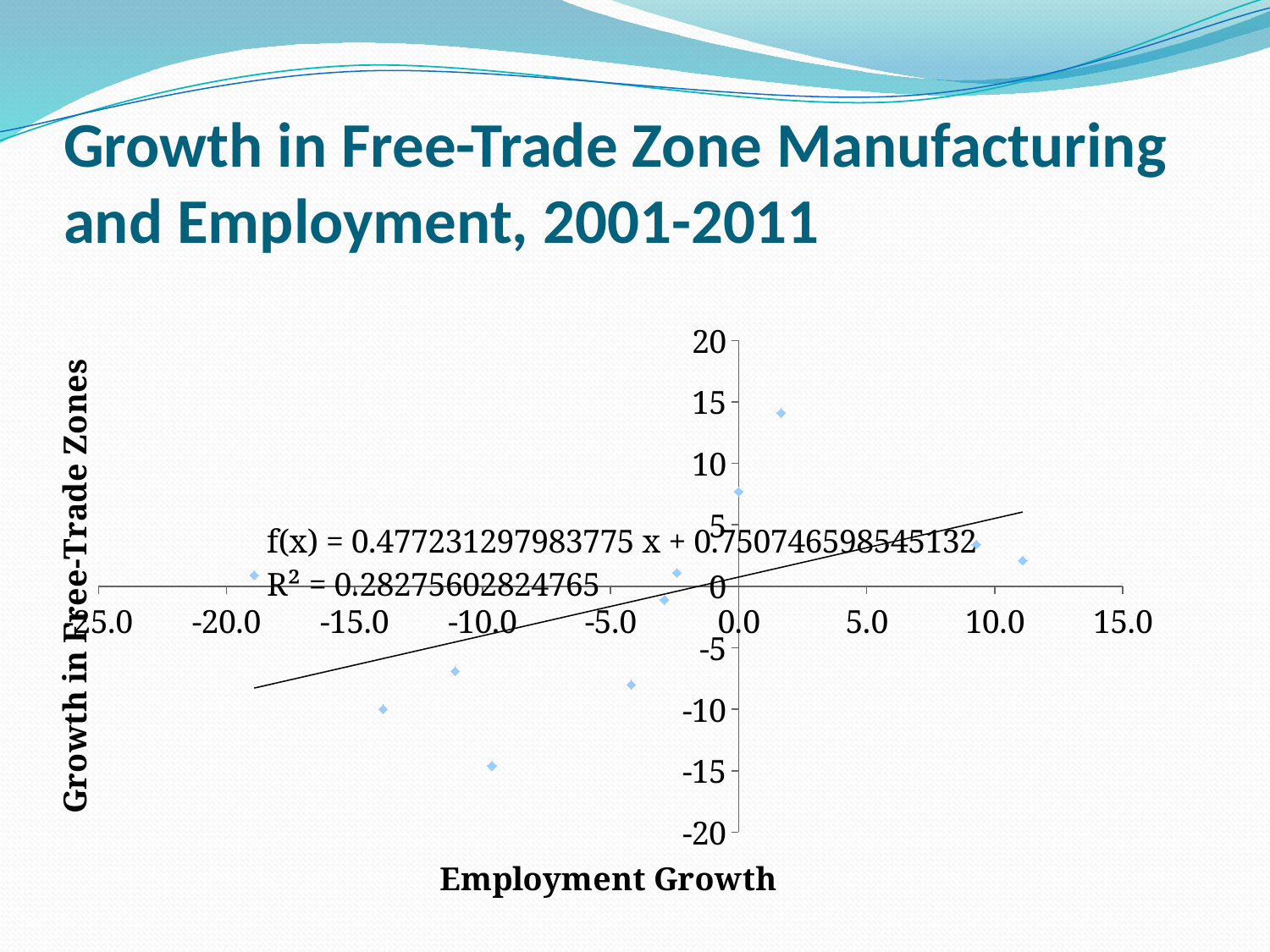
What is the intercept in the trendline equation f(x)? 0.750746598545132 What is the maximum value shown on the y axis? 20 What is the R² value shown for the trendline? 0.28275602824765 Does the fitted trendline rise or fall as Employment Growth increases? rise Is the Employment Growth of the leftmost plotted point greater or less than -15.0? less What is the slope coefficient in the trendline equation f(x)? 0.477231297983775 Is the highest plotted value of Growth in Free-Trade Zones greater or less than 10? greater What is the label of the x axis? Employment Growth Is the lowest plotted value of Growth in Free-Trade Zones greater or less than -10? less What is the title of the chart on the slide? Growth in Free-Trade Zone Manufacturing and Employment, 2001-2011 What kind of chart is shown on the slide? scatter chart How many data points are plotted on the scatter chart? 11